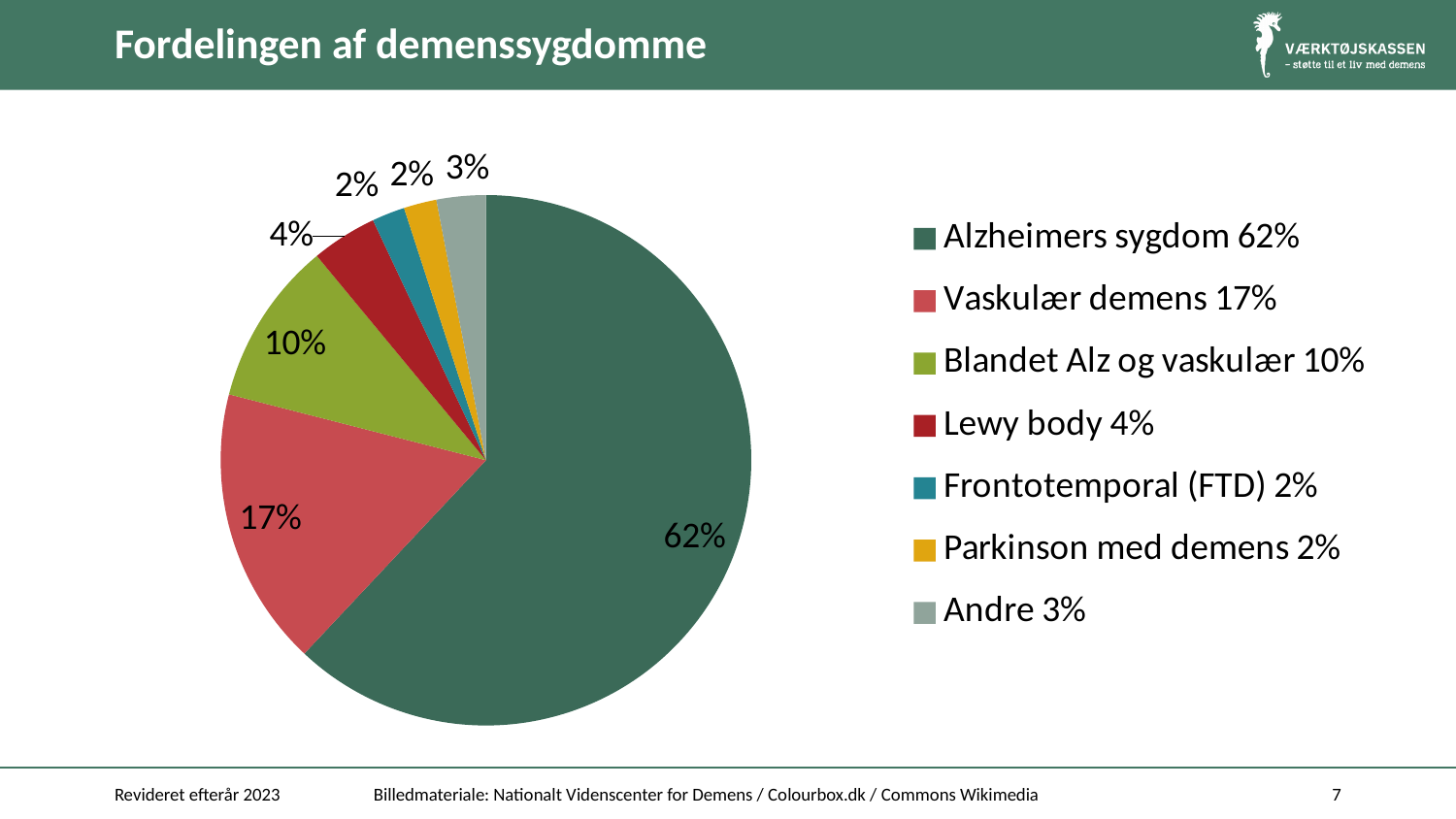
What is the value shown for Vaskulær demens? 17% What is the difference between the values for Alzheimers sygdom and Vaskulær demens? 45% Which is larger, the value for Blandet Alz og vaskulær or the value for Lewy body? Blandet Alz og vaskulær What is the value shown for Blandet Alz og vaskulær? 10% What is the title of the slide containing the chart? Fordelingen af demenssygdomme What is the value shown for Andre? 3% What kind of chart is shown on the slide? Pie chart Which category has the largest slice of the pie? Alzheimers sygdom What share of the pie does Alzheimers sygdom have? 62% What is the combined value of Frontotemporal (FTD) and Parkinson med demens? 4% What is the value shown for Lewy body? 4% How many categories does the legend list? 7